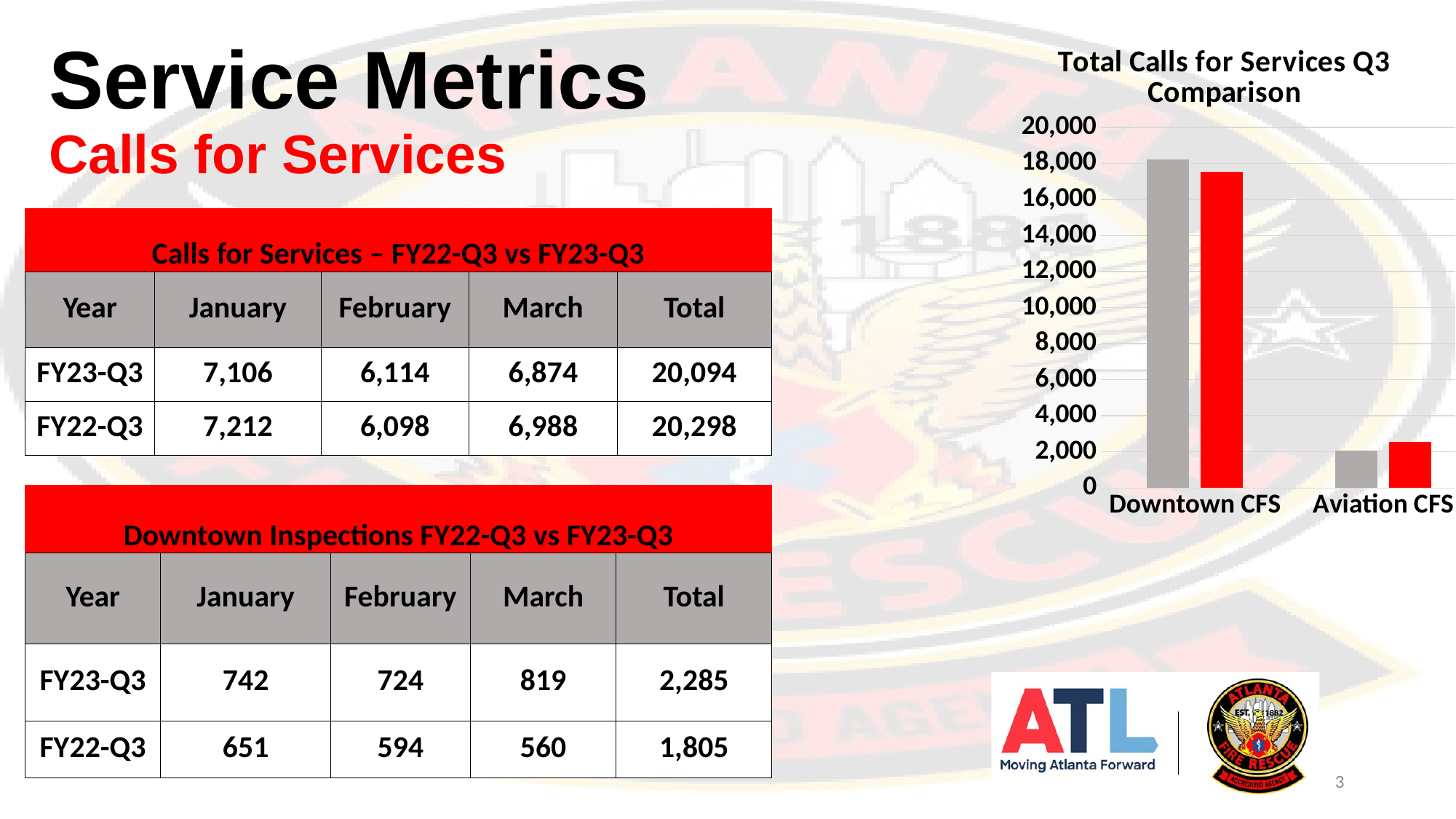
Is the value of the gray bar for Aviation CFS greater or less than 4,000? less Which category in the chart has the lowest bars? Aviation CFS Is the value of the red bar for Aviation CFS greater or less than 4,000? less What is the highest value labelled on the chart's vertical axis? 20,000 Is the value of the gray bar for Downtown CFS greater or less than 16,000? greater For Aviation CFS, which bar is taller, the gray bar or the red bar? the red bar Which category in the chart has the highest bars? Downtown CFS Which is larger in the chart, the red bar for Downtown CFS or the red bar for Aviation CFS? Downtown CFS What kind of chart is shown on the slide? bar chart How many categories are shown on the x axis of the chart? 2 What is the title of the chart on the slide? Total Calls for Services Q3 Comparison